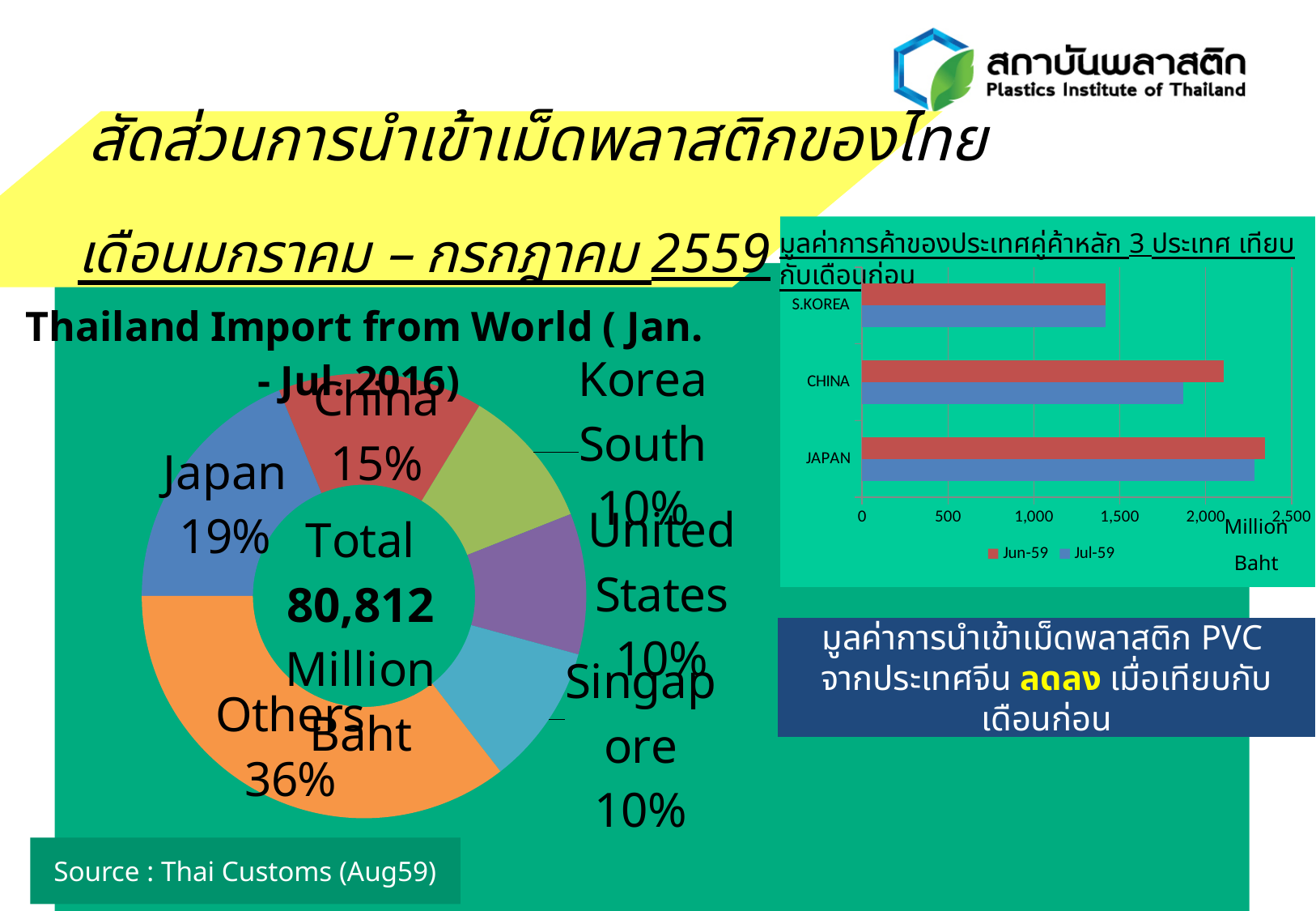
What kind of chart is the 'Thailand Import from World (Jan. - Jul. 2016)' chart on the left? doughnut chart How many series does the legend of the bar chart on the right list? 2 In the 'Thailand Import from World (Jan. - Jul. 2016)' chart, how many percentage points larger is Japan's share than China's? 4 In the bar chart on the right, which is larger for CHINA, Jun-59 or Jul-59? Jun-59 In the 'Thailand Import from World (Jan. - Jul. 2016)' chart, what share does Japan have? 19% In the 'Thailand Import from World (Jan. - Jul. 2016)' chart, which slice is the largest? Others In the 'Thailand Import from World (Jan. - Jul. 2016)' chart, what total is shown in the centre? 80,812 Million Baht What kind of chart is the chart on the right of the slide showing S.KOREA, CHINA and JAPAN? bar chart How many slices does the 'Thailand Import from World (Jan. - Jul. 2016)' chart have? 6 In the bar chart on the right, is the Jun-59 value for CHINA greater or less than 2,000? greater In the 'Thailand Import from World (Jan. - Jul. 2016)' chart, what share does China have? 15% In the 'Thailand Import from World (Jan. - Jul. 2016)' chart, what share does Others have? 36%